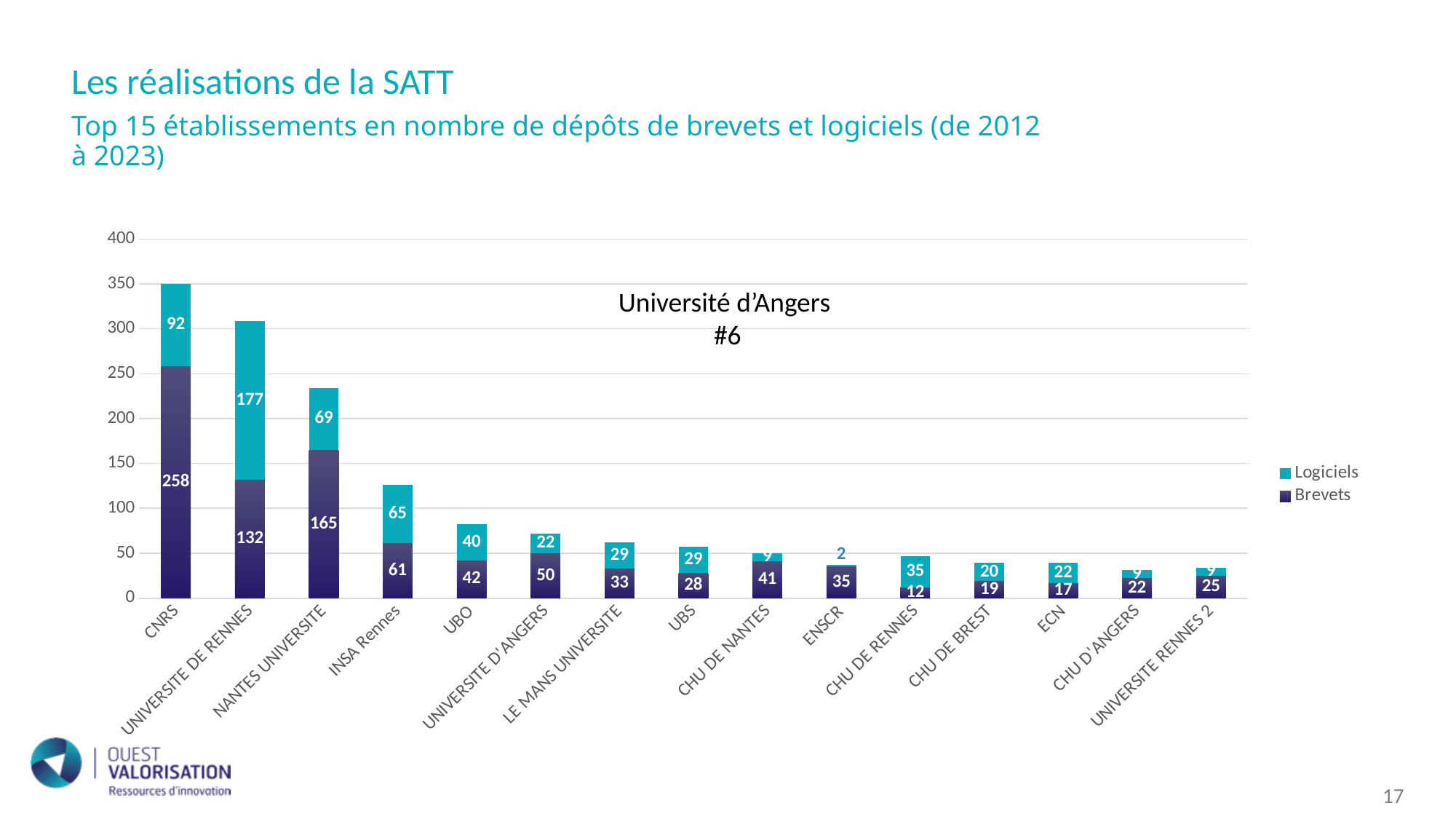
Which establishment has the highest Logiciels value? UNIVERSITE DE RENNES What is the difference between the Brevets values of CNRS and NANTES UNIVERSITE? 93 Which series is shown in dark purple in the legend? Brevets What is the Logiciels value for UNIVERSITE DE RENNES? 177 What is the total of the stacked bar for CNRS? 350 How many series does the legend list? 2 How many establishments are shown on the x axis? 15 What is the Brevets value for CNRS? 258 What is the Brevets value for NANTES UNIVERSITE? 165 What kind of chart is shown on the slide? Stacked bar chart Which is larger for INSA Rennes, the Brevets value or the Logiciels value? Logiciels Which establishment has the lowest Logiciels value? ENSCR